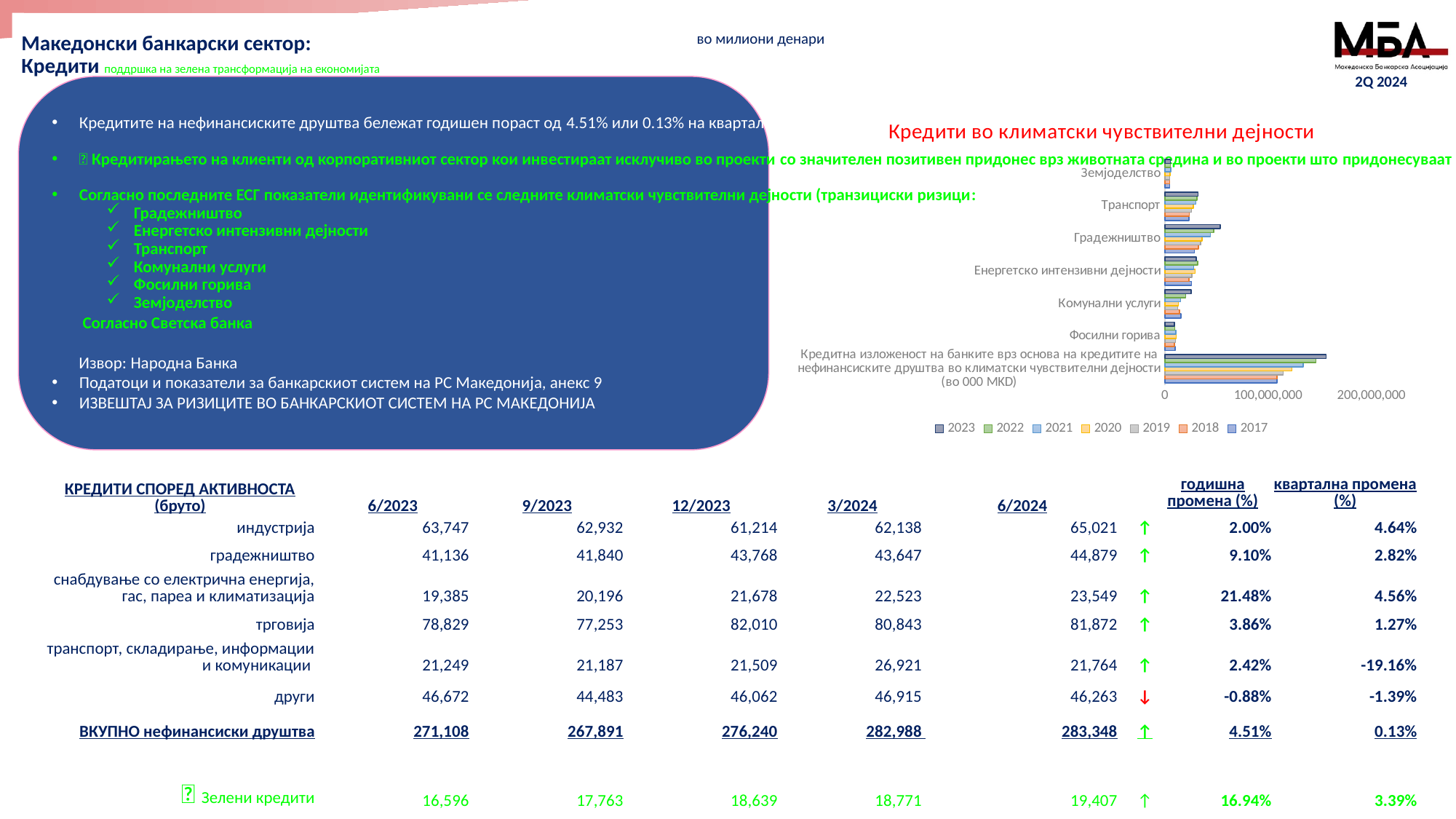
Among the individual sectors (excluding the total category), which has the longest bars in the chart? Градежништво Which has larger values in the chart, Градежништво or Фосилни горива? Градежништво Which years are listed in the chart legend? 2023, 2022, 2021, 2020, 2019, 2018, 2017 Which has larger values in the chart, Транспорт or Земјоделство? Транспорт How many categories are shown on the vertical axis of the chart? 7 What is the title of the chart on the slide? Кредити во климатски чувствителни дејности For the total category, which year has the longest bar? 2023 Is the 2023 value for Градежништво greater or less than 100,000,000? less Which category has the shortest bars in the chart? Земјоделство What kind of chart is shown on the slide? bar chart How many series does the chart legend list? 7 Is the 2023 value for the total category (Кредитна изложеност на банките ... во климатски чувствителни дејности) greater or less than 100,000,000? greater